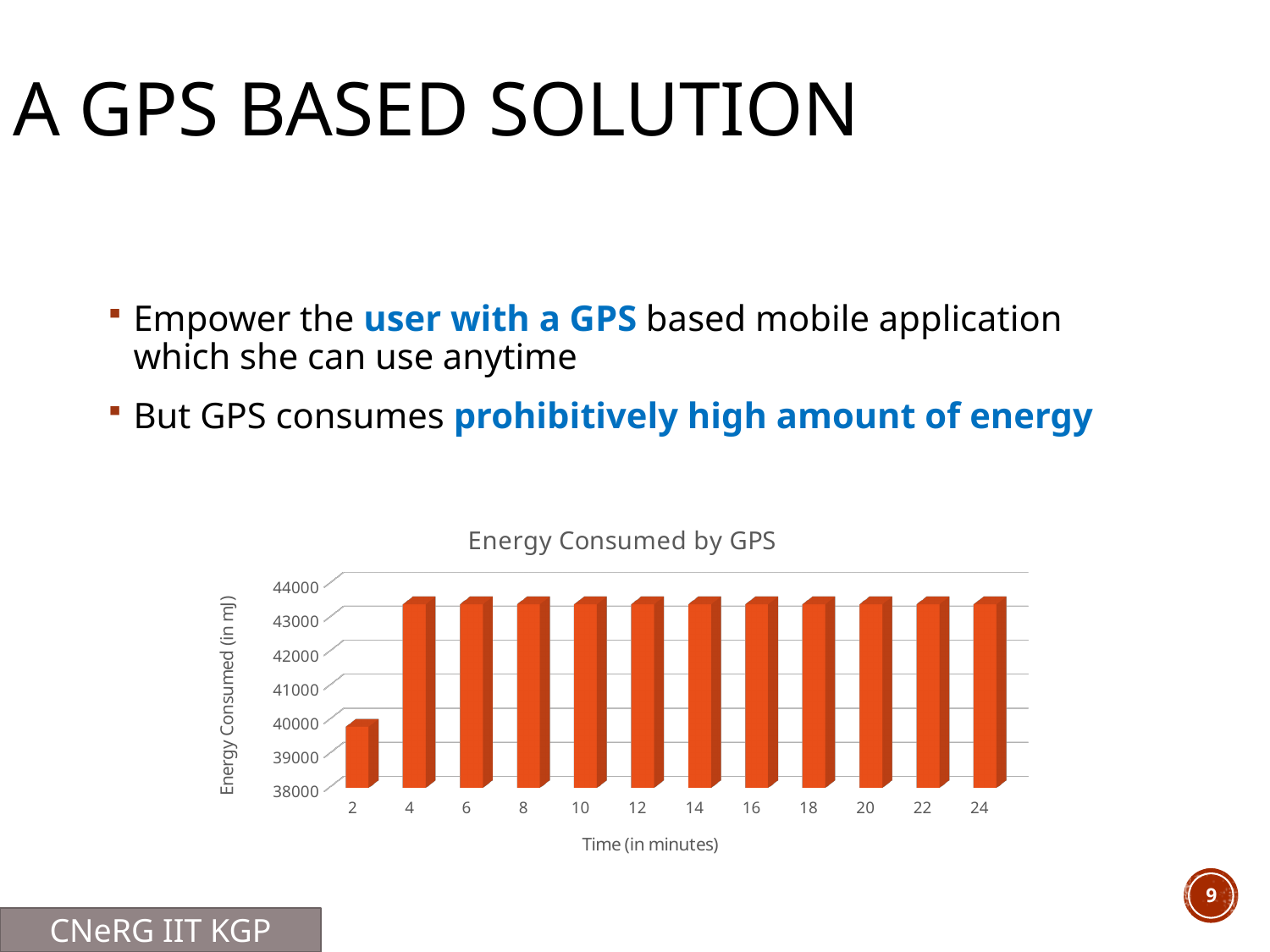
What kind of chart is shown on the slide? bar chart Which time (in minutes) has the lowest energy consumed? 2 Is the energy consumed at 24 minutes greater or less than 44000? less What is the title of the chart? Energy Consumed by GPS Is the energy consumed at 12 minutes greater or less than 42000? greater What is the label of the x axis of the chart? Time (in minutes) Which has lower energy consumed: 2 minutes or 20 minutes? 2 minutes Is the energy consumed at 4 minutes greater or less than 43000? greater Which has higher energy consumed: 2 minutes or 4 minutes? 4 minutes How many time categories are shown on the x axis of the chart? 12